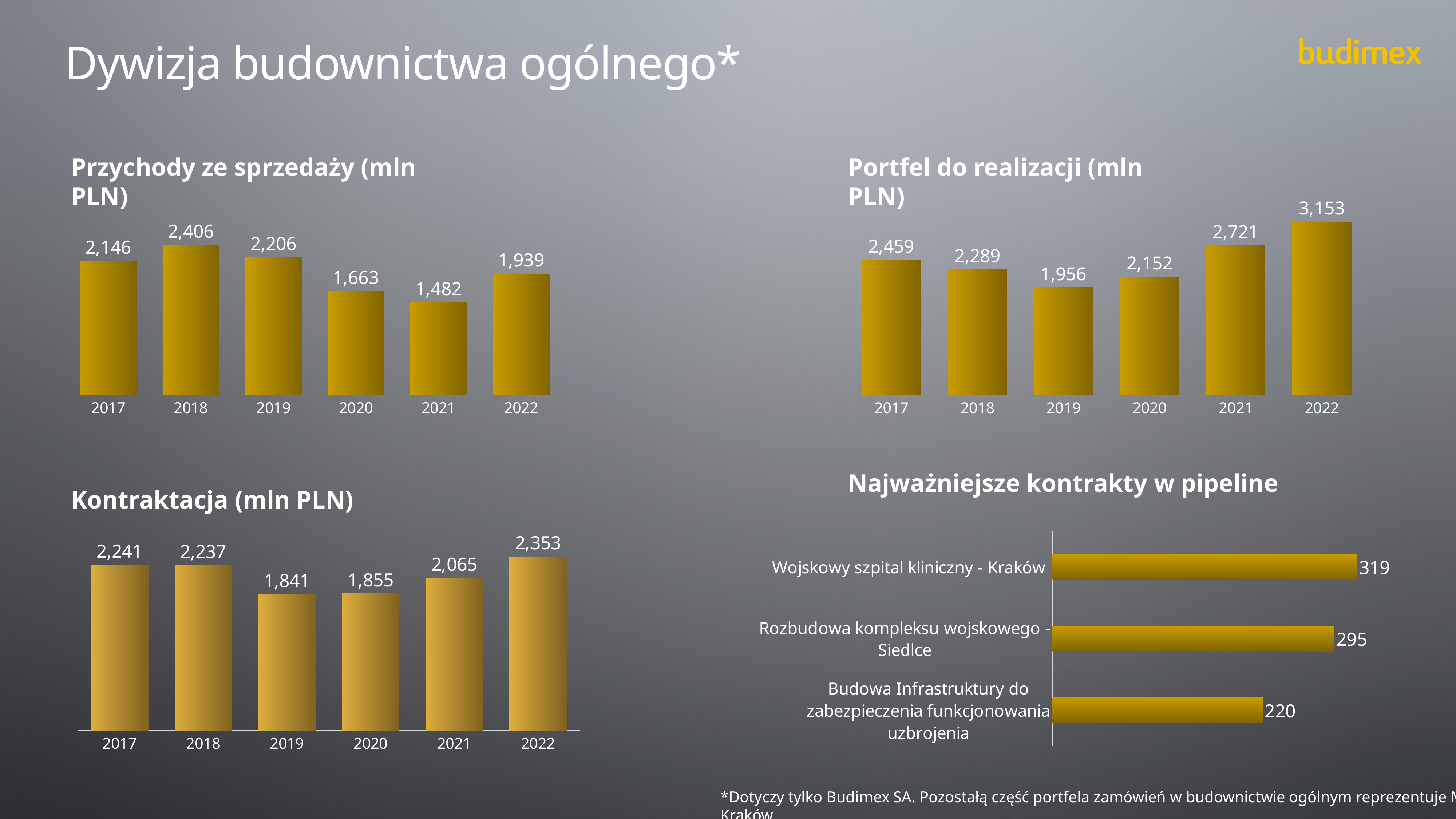
In the 'Kontraktacja (mln PLN)' chart, how many years are shown? 6 In the 'Przychody ze sprzedaży (mln PLN)' chart, what is the value for 2018? 2,406 In the 'Przychody ze sprzedaży (mln PLN)' chart, what is the difference between the 2022 and 2021 values? 457 In the 'Portfel do realizacji (mln PLN)' chart, which is larger, the value for 2017 or the value for 2018? 2017 In the 'Kontraktacja (mln PLN)' chart, which year has the lowest value? 2019 In the 'Kontraktacja (mln PLN)' chart, what is the value for 2020? 1,855 What kind of chart is the 'Najważniejsze kontrakty w pipeline' chart? bar chart In the 'Przychody ze sprzedaży (mln PLN)' chart, which year has the lowest value? 2021 In the 'Najważniejsze kontrakty w pipeline' chart, what is the difference between the 'Wojskowy szpital kliniczny - Kraków' value and the 'Budowa Infrastruktury do zabezpieczenia funkcjonowania uzbrojenia' value? 99 In the 'Najważniejsze kontrakty w pipeline' chart, what is the value for 'Rozbudowa kompleksu wojskowego - Siedlce'? 295 In the 'Portfel do realizacji (mln PLN)' chart, which year has the highest value? 2022 In the 'Portfel do realizacji (mln PLN)' chart, what is the value for 2021? 2,721